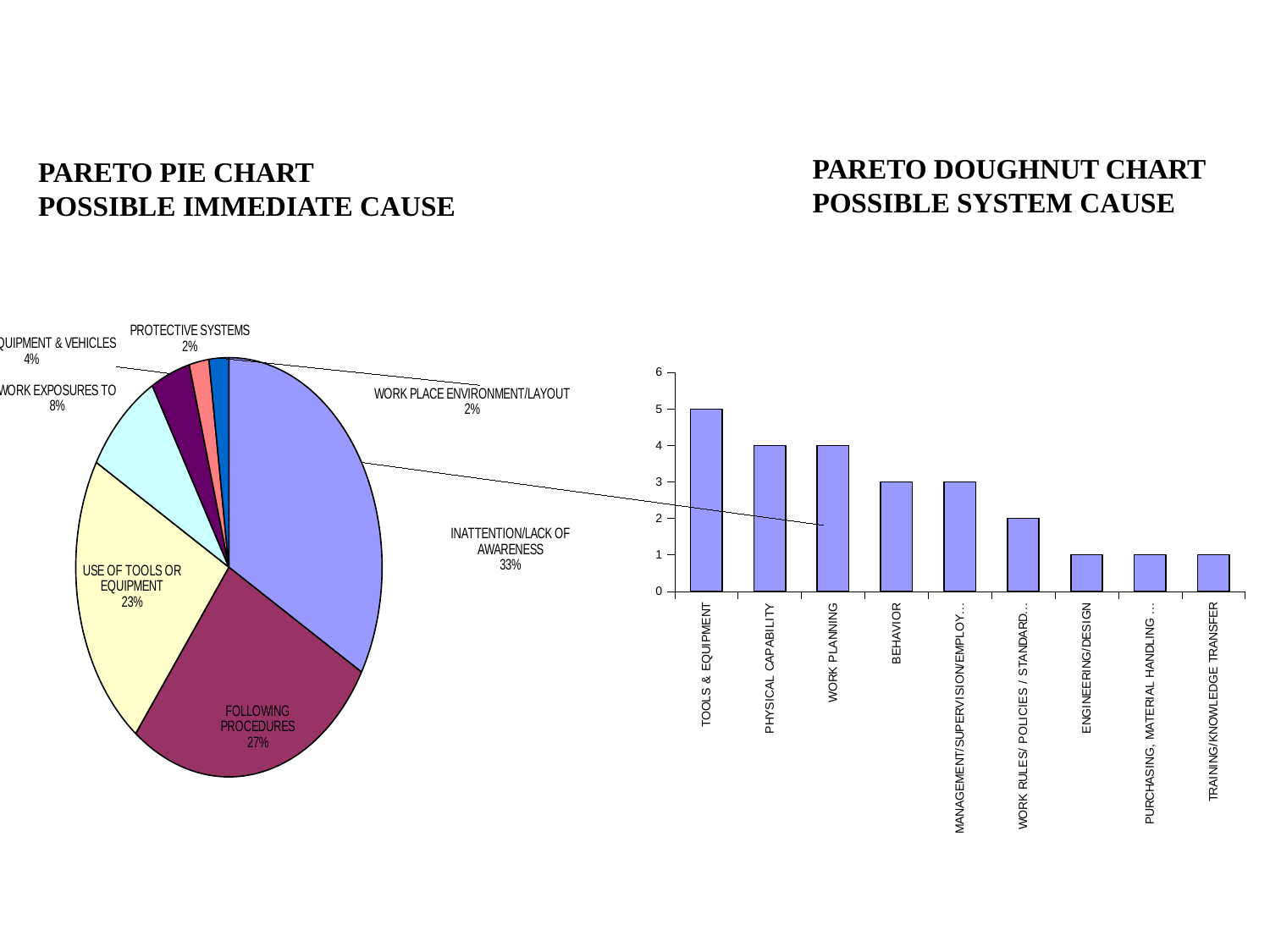
In the Pareto Pie Chart (left), which is larger: Use of Tools or Equipment or Protective Systems? Use of Tools or Equipment How many bars are in the bar chart on the right (Possible System Cause)? 9 In the Pareto Pie Chart (left), what share of the pie is Inattention/Lack of Awareness? 33% What kind of chart is the chart on the right of the slide, under the heading Pareto Doughnut Chart? Bar chart In the Pareto Pie Chart (left), what is the difference in percentage points between Following Procedures and Use of Tools or Equipment? 4 In the bar chart on the right (Possible System Cause), which category has the highest value? Tools & Equipment In the bar chart on the right (Possible System Cause), what is the value for Tools & Equipment? 5 In the bar chart on the right (Possible System Cause), what is the value for Behavior? 3 In the Pareto Pie Chart (left), what percentage is shown for Following Procedures? 27% In the Pareto Pie Chart (left), which category has the largest slice? Inattention/Lack of Awareness How many slices does the Pareto Pie Chart (left) have? 7 In the bar chart on the right (Possible System Cause), do the values rise or fall from left to right along the x axis? Fall